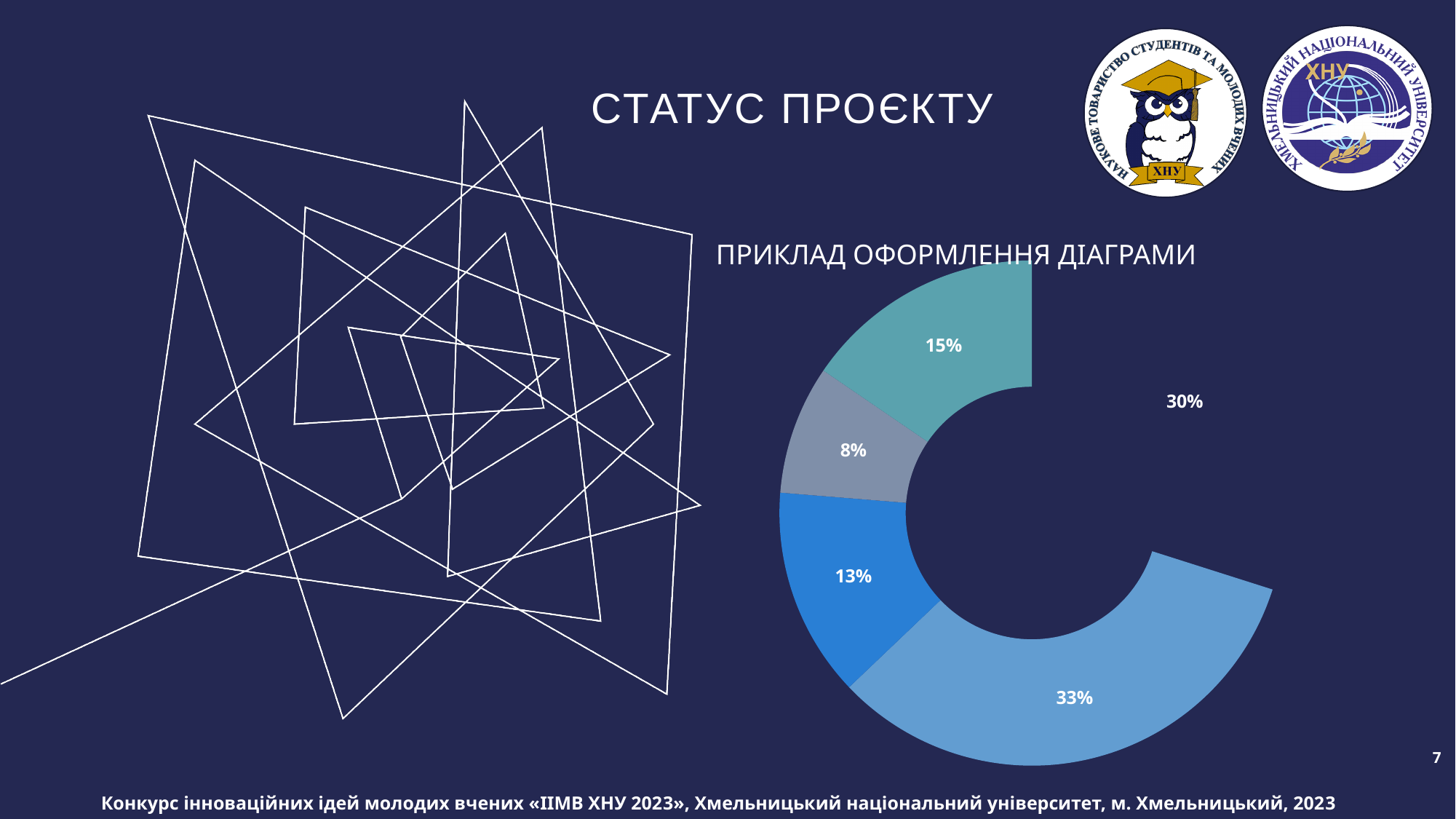
Which is larger, the slice labelled 33% or the slice labelled 30%? 33% What is the largest percentage value labelled on the chart? 33% Does the chart have a legend listing its categories? No How many percentage data labels are shown on the chart? 5 What is the difference between the slices labelled 15% and 8%? 7 percentage points What colour is the slice labelled 33%? Light blue What is the sum of the slices labelled 13% and 15%? 28% What is the difference between the largest and smallest labelled values on the chart? 25 percentage points Is the slice labelled 8% greater or less than 10%? less What is the smallest percentage value labelled on the chart? 8% What kind of chart is shown on the slide? Doughnut (pie) chart What is the title of the chart on the slide? ПРИКЛАД ОФОРМЛЕННЯ ДІАГРАМИ